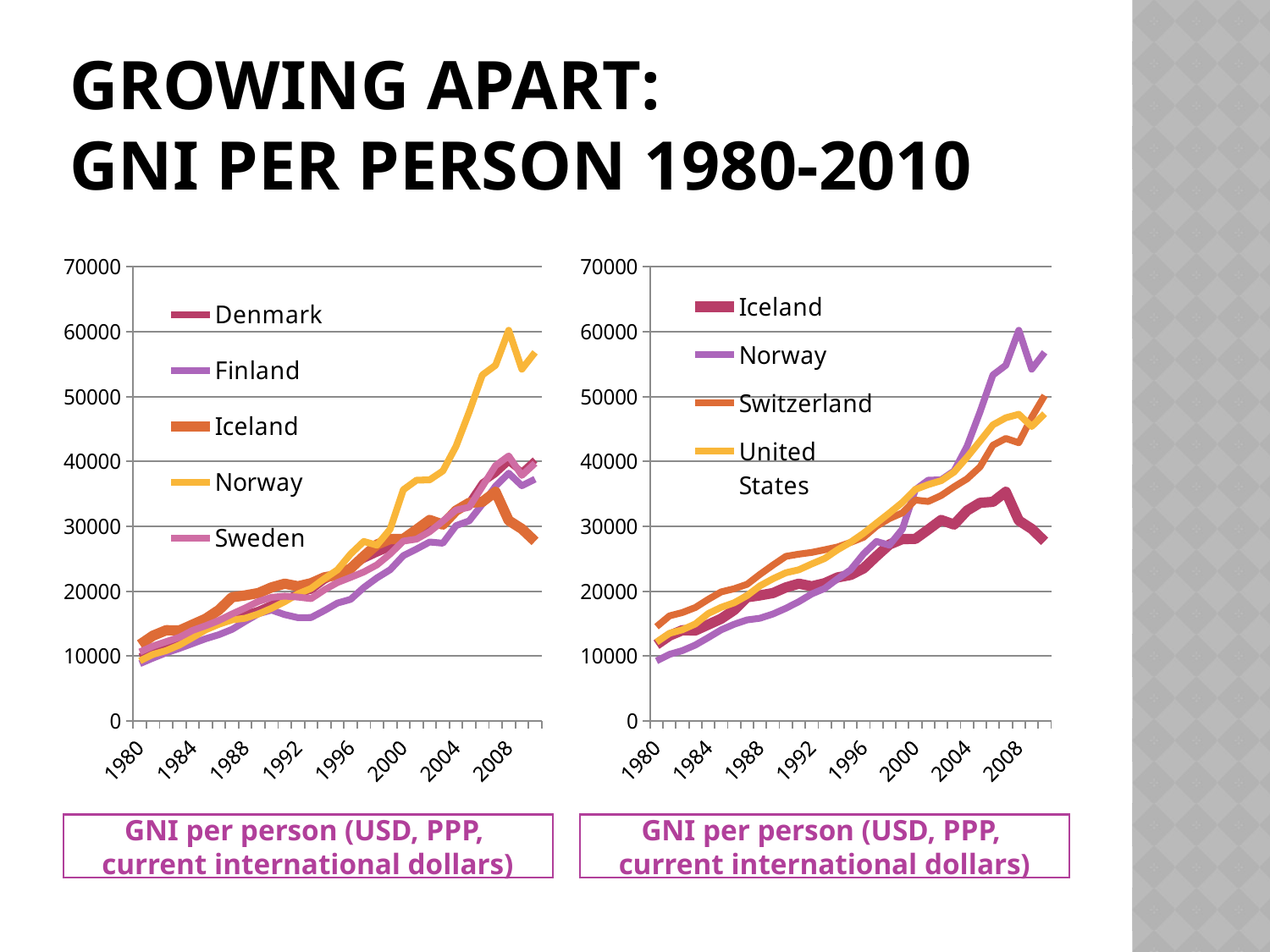
In the right chart, which series has the lowest value in 2010? Iceland How many series does the legend of the left chart list? 5 In the left chart, does the value for Norway generally rise or fall from 1980 to 2008? rise In the left chart, is the value for Finland in 1994 greater or less than 20000? less How many series does the legend of the right chart list? 4 In the right chart, is the value for Iceland in 2010 greater or less than 30000? less What type of chart is the left chart on the slide? line chart Which country appears in the legends of both the left and right charts besides Norway? Iceland In the left chart, which series reaches the highest value? Norway In the right chart, which is larger in 2010, Norway or Iceland? Norway In the right chart, is the value for United States in 2000 greater or less than 30000? greater